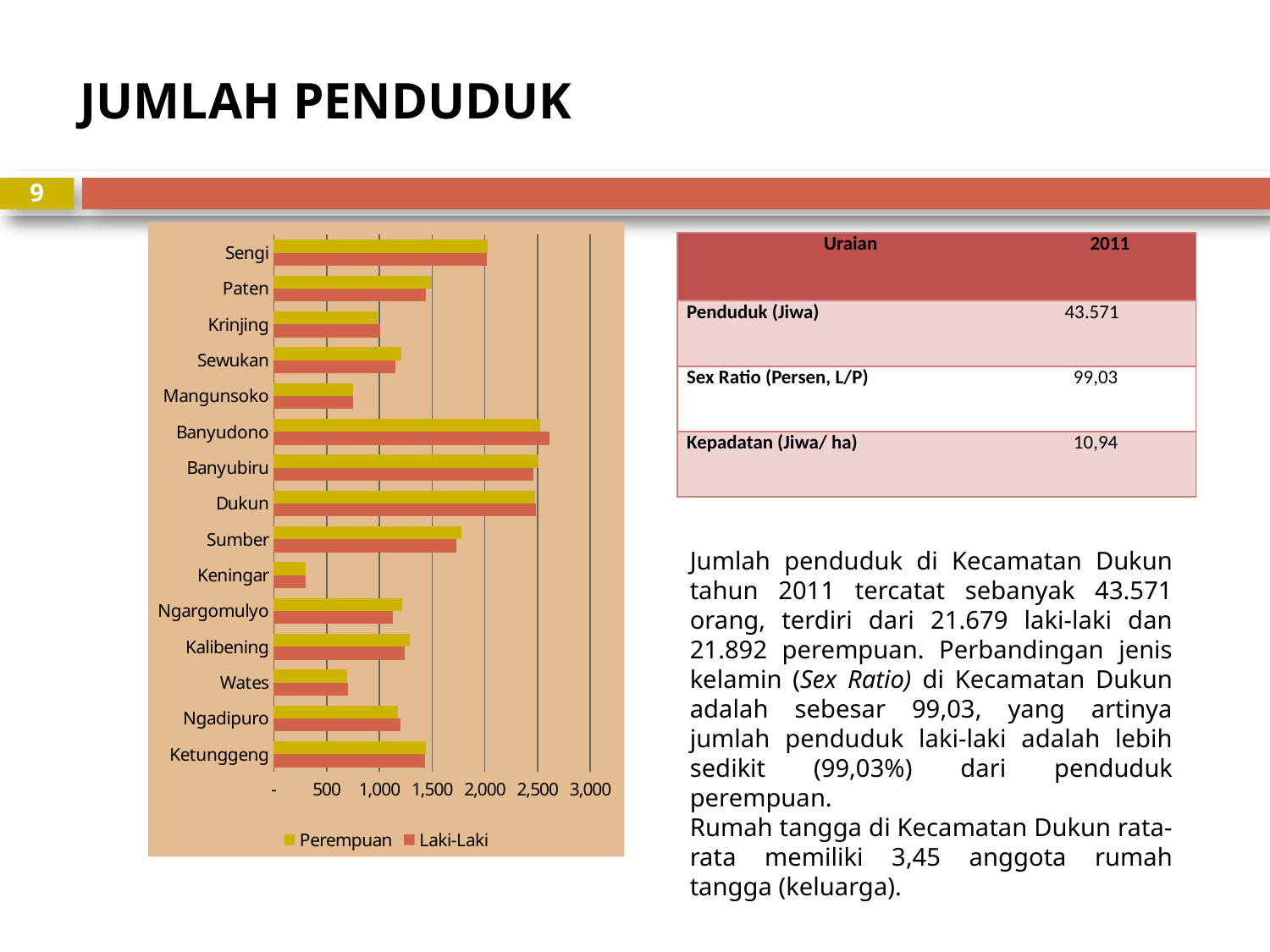
Is the Perempuan value for Sumber greater or less than 1,500? greater Which is larger, the Perempuan value for Sengi or for Sumber? Sengi Which is larger, the Perempuan value for Wates or for Keningar? Wates Is the Perempuan value for Keningar greater or less than 500? less Is the Perempuan value for Mangunsoko greater or less than 1,000? less How many series does the chart legend list? 2 Which category has the lowest Perempuan value? Keningar What kind of chart is shown on the slide? bar chart Which category has the highest Laki-Laki value? Banyudono What are the two series named in the chart legend? Perempuan and Laki-Laki How many categories (villages) are plotted on the chart? 15